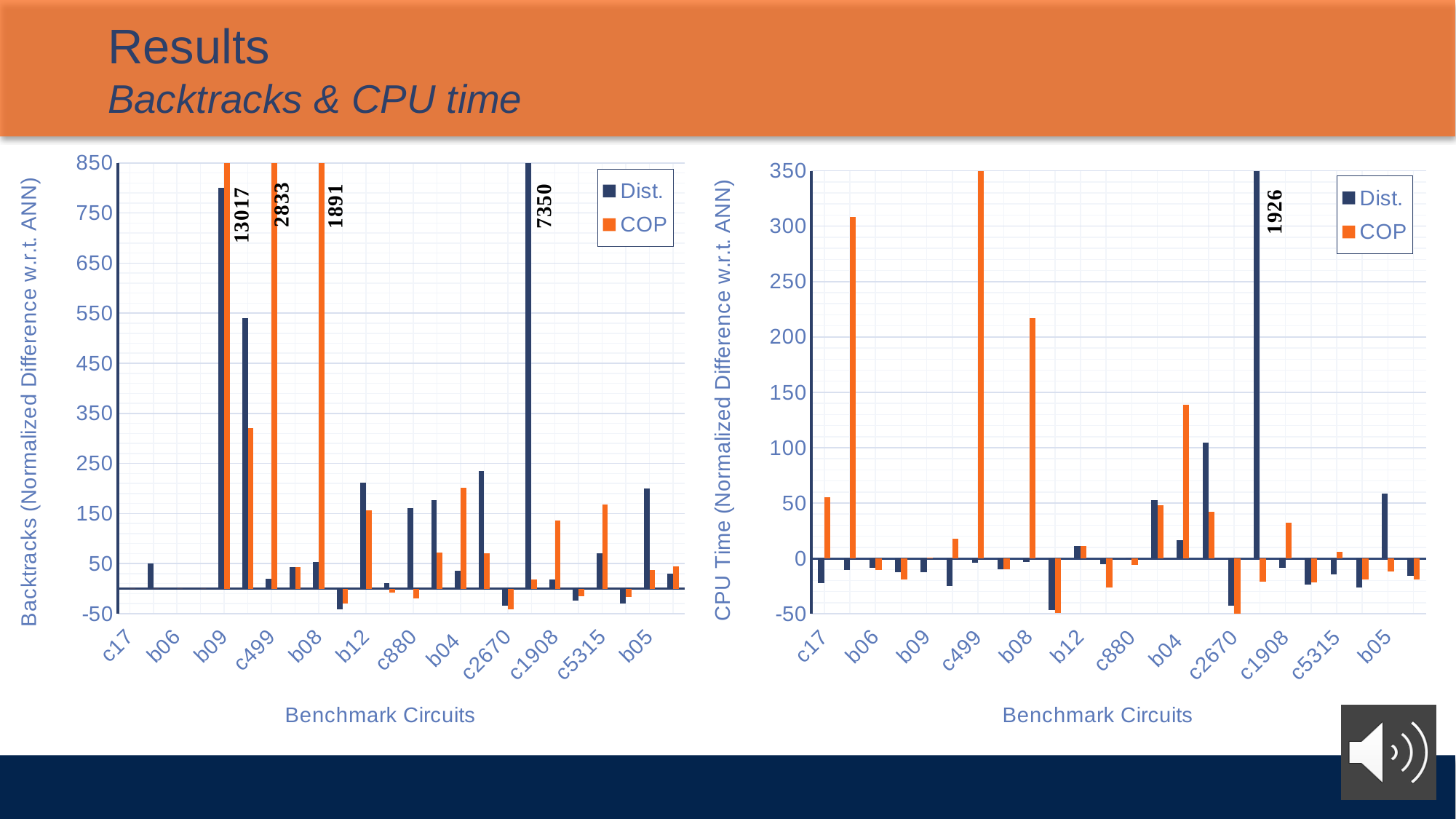
On the left chart (Backtracks), what is the largest data label printed? 13017 On the left chart (Backtracks), what is the smallest data label printed? 1891 How many data labels are printed on the left chart (Backtracks)? 4 What is the x-axis title of the right chart (CPU Time)? Benchmark Circuits On the left chart (Backtracks), what value is printed beside the tallest Dist. bar? 7350 On the right chart (CPU Time), which series does the bar labeled 1926 belong to? Dist. What kind of chart is the left chart (Backtracks)? bar chart On the left chart (Backtracks), what is the difference between the data labels 13017 and 7350? 5667 How many series does the legend of the right chart (CPU Time) list? 2 On the right chart (CPU Time), is the tallest COP bar greater or less than 300? greater What are the two legend entries on the left chart (Backtracks)? Dist. and COP On the right chart (CPU Time), what is the only data label printed? 1926